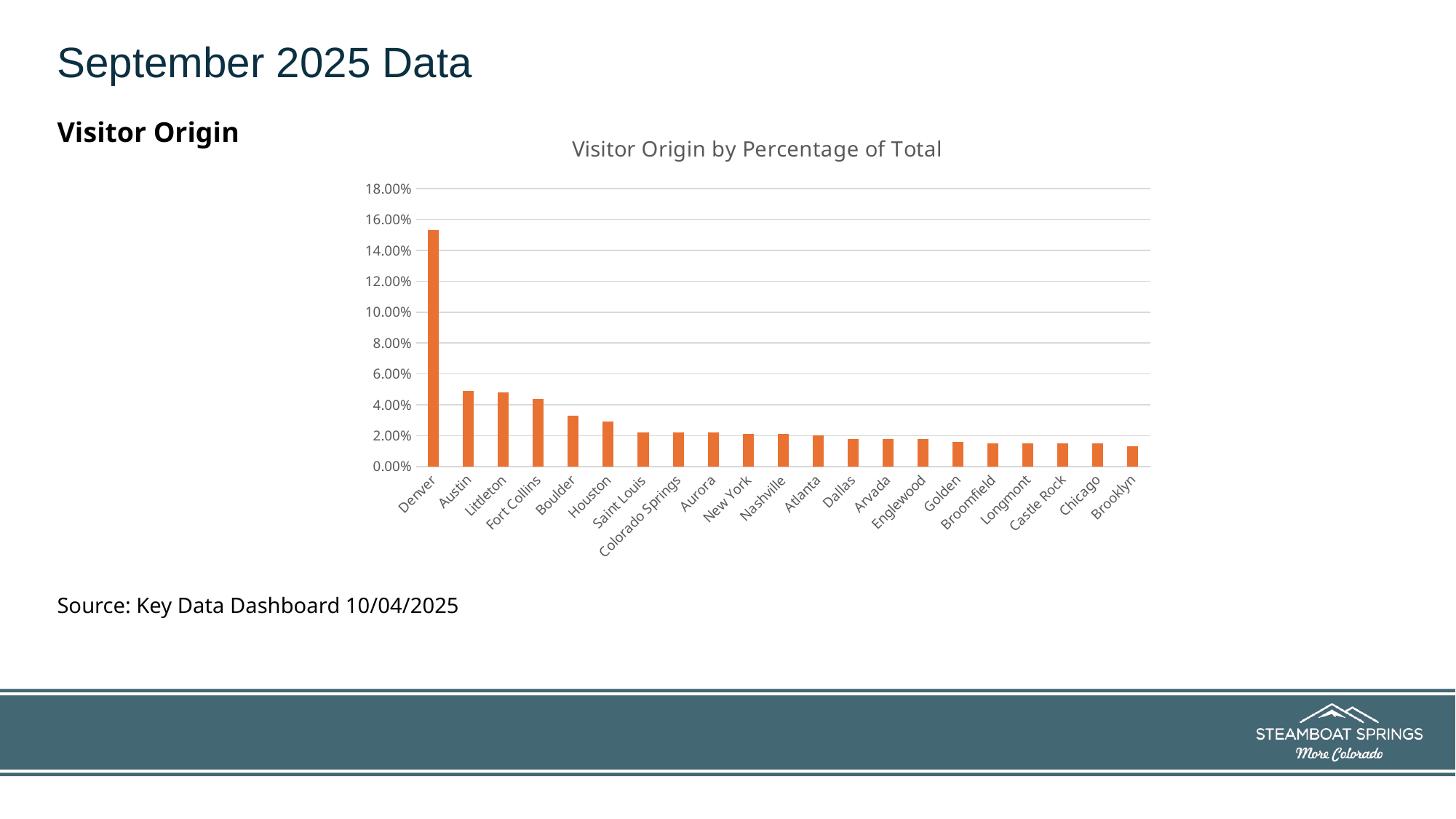
Is the value for Austin greater or less than 6.00%? less What is the title of the chart? Visitor Origin by Percentage of Total Is the value for Denver greater or less than 14.00%? greater What colour are the bars in the chart? Orange How many visitor origin categories are shown on the x axis? 21 Is the value for Brooklyn greater or less than 2.00%? less Which visitor origin has the highest percentage of total? Denver Which visitor origin has the lowest percentage of total? Brooklyn Do the values generally rise or fall moving from left to right along the x axis? Fall Which has a larger percentage of total, Fort Collins or Boulder? Fort Collins What kind of chart is shown on the slide? Bar chart